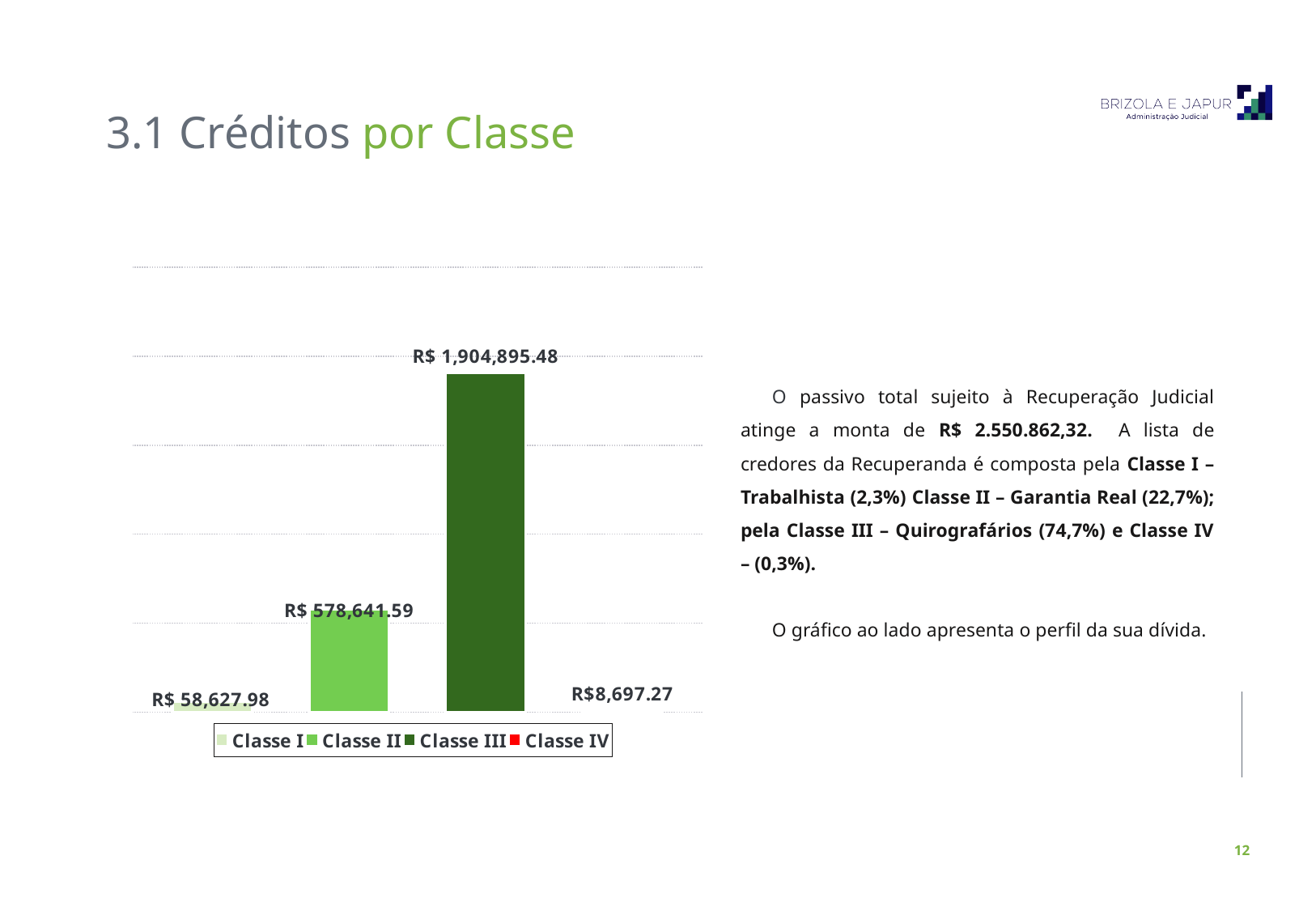
What kind of chart is shown on the slide? Bar chart How many series does the legend list? 4 What is the value shown for Classe I? R$ 58,627.98 Which is larger, the value for Classe I or the value for Classe IV? Classe I What is the value shown for Classe IV? R$8,697.27 Which legend entry is shown in red? Classe IV Which class has the highest value in the chart? Classe III Which class has the lowest value in the chart? Classe IV What is the difference between the values for Classe II and Classe I? R$ 520,013.61 What is the difference between the values for Classe III and Classe II? R$ 1,326,253.89 What is the value shown for Classe III? R$ 1,904,895.48 What is the value shown for Classe II? R$ 578,641.59